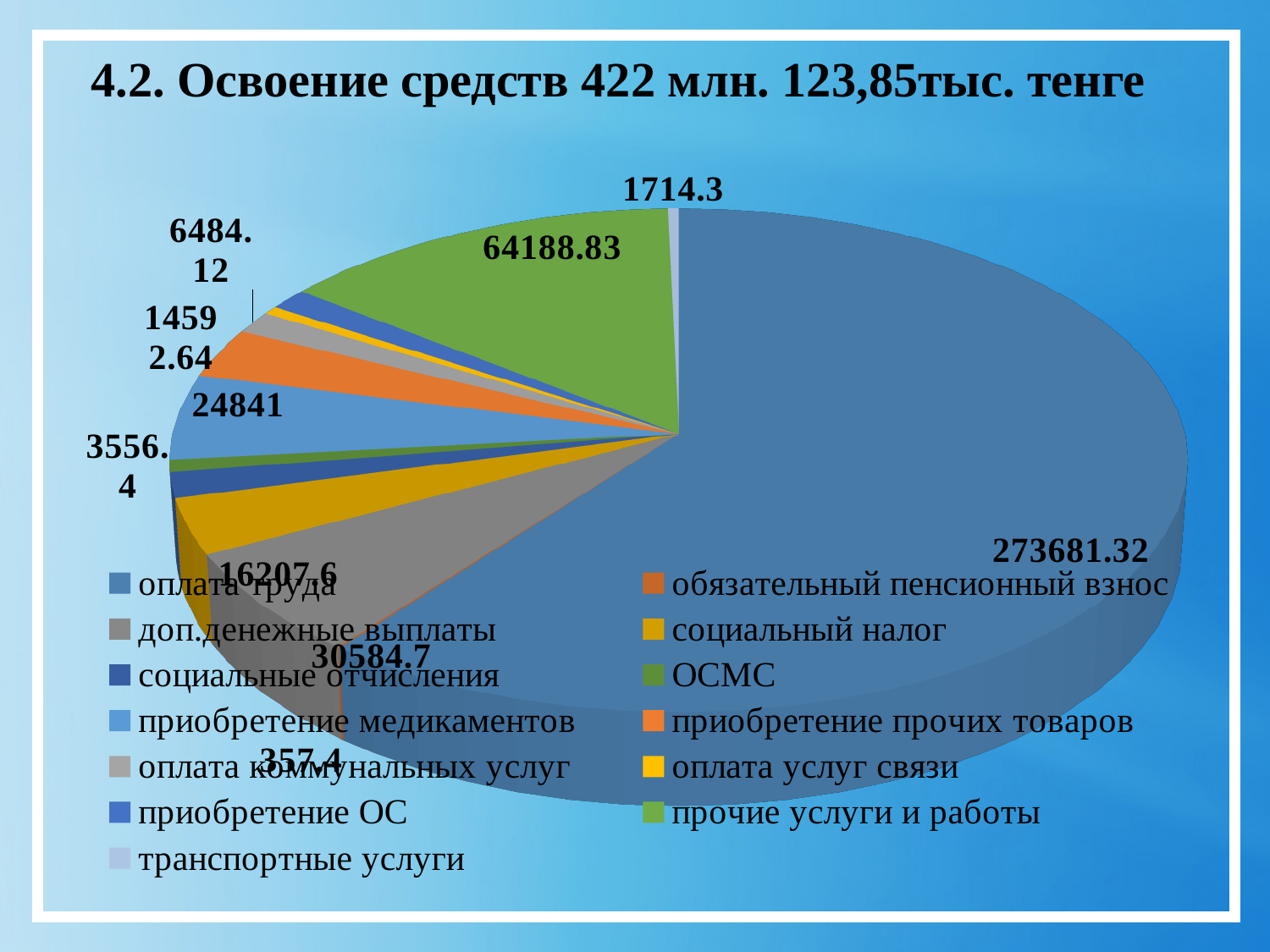
What is the value for прочие услуги и работы? 64188.83 What is the value for доп.денежные выплаты? 30584.7 What is the value for транспортные услуги? 1714.3 Which category has the largest slice of the pie? оплата труда What is the value for социальный налог? 16207.6 What is the title of the chart on the slide? 4.2. Освоение средств 422 млн. 123,85тыс. тенге What is the value for оплата труда? 273681.32 How many categories does the legend of the pie chart list? 13 What kind of chart is shown on the slide? pie chart What is the value for приобретение медикаментов? 24841 What is the difference between оплата труда and прочие услуги и работы? 209492.49 Which is larger, прочие услуги и работы or приобретение медикаментов? прочие услуги и работы